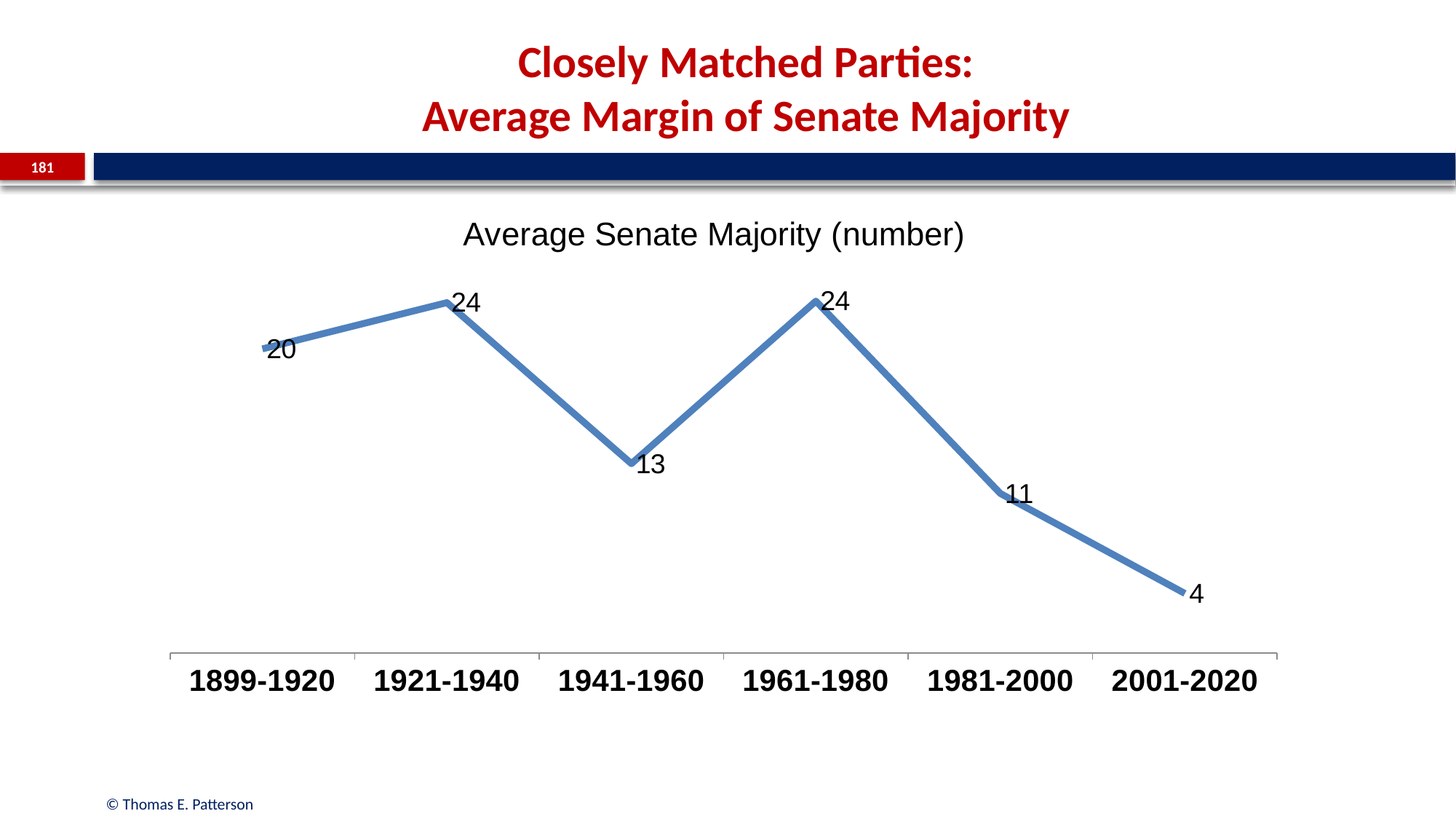
Which is larger, the average Senate majority for 1899-1920 or for 1941-1960? 1899-1920 Which period has the lowest average Senate majority? 2001-2020 What is the title of the chart? Average Senate Majority (number) What kind of chart is shown on the slide? line chart What is the average Senate majority for 1899-1920? 20 What is the difference between the average Senate majority for 1921-1940 and 1941-1960? 11 What is the difference between the average Senate majority for 1961-1980 and 1981-2000? 13 What is the average Senate majority for 1981-2000? 11 What is the average Senate majority for 2001-2020? 4 What is the highest value plotted on the chart? 24 How many time periods are plotted on the chart? 6 What is the average Senate majority for 1941-1960? 13